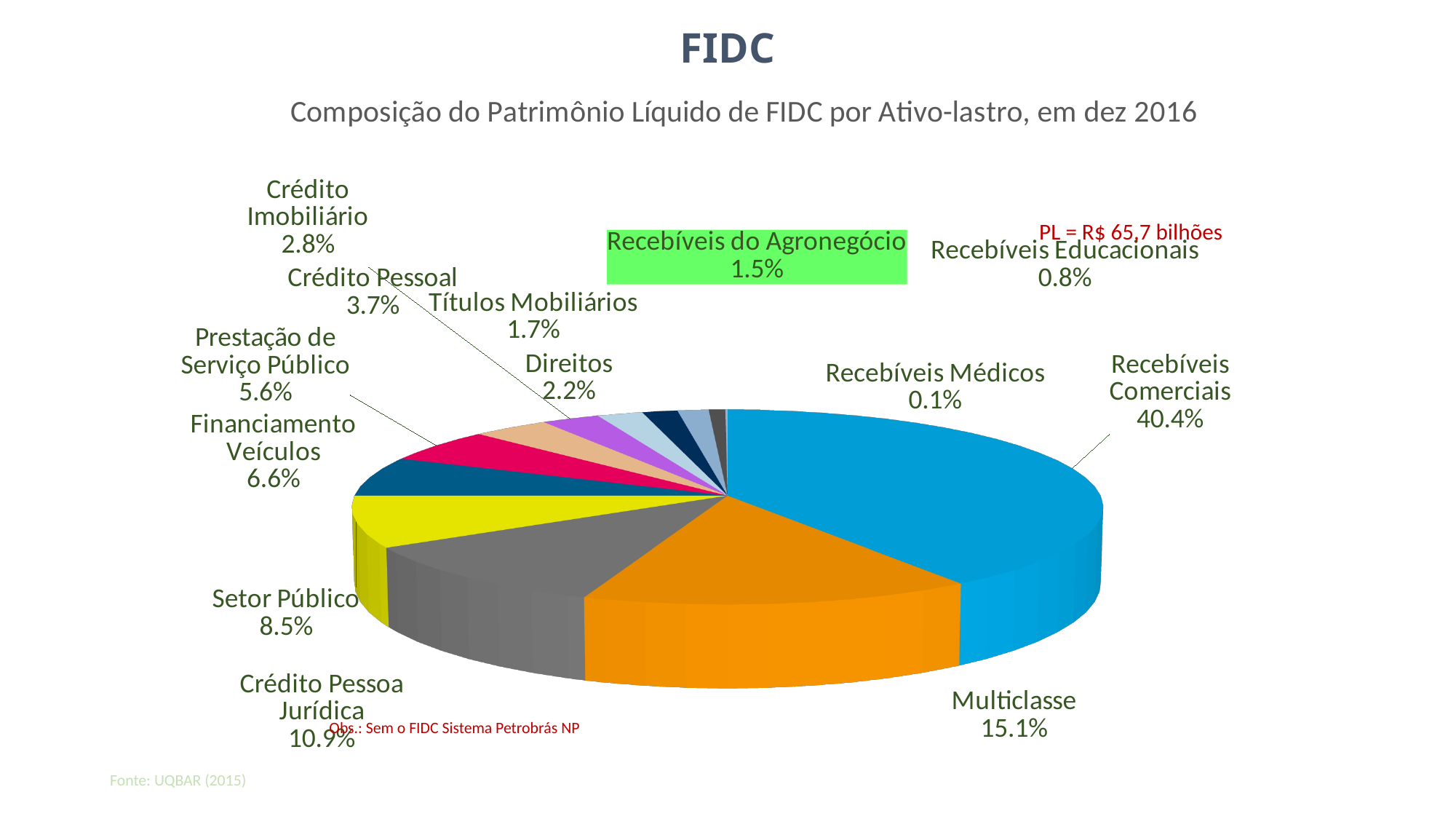
What is the value for Recebíveis do Agronegócio? 1.5% Which category has the largest slice of the pie? Recebíveis Comerciais What is the value shown for Multiclasse? 15.1% How many categories are shown in the pie chart? 13 Which is larger, Financiamento Veículos or Prestação de Serviço Público? Financiamento Veículos What share of the pie does Recebíveis Comerciais represent? 40.4% Which is larger, Crédito Pessoal or Crédito Imobiliário? Crédito Pessoal What is the title of the chart? Composição do Patrimônio Líquido de FIDC por Ativo-lastro, em dez 2016 What is the difference between the shares of Recebíveis Comerciais and Multiclasse? 25.3% What type of chart is shown on the slide? Pie chart Which category has the smallest slice of the pie? Recebíveis Médicos What percentage is shown for Setor Público? 8.5%